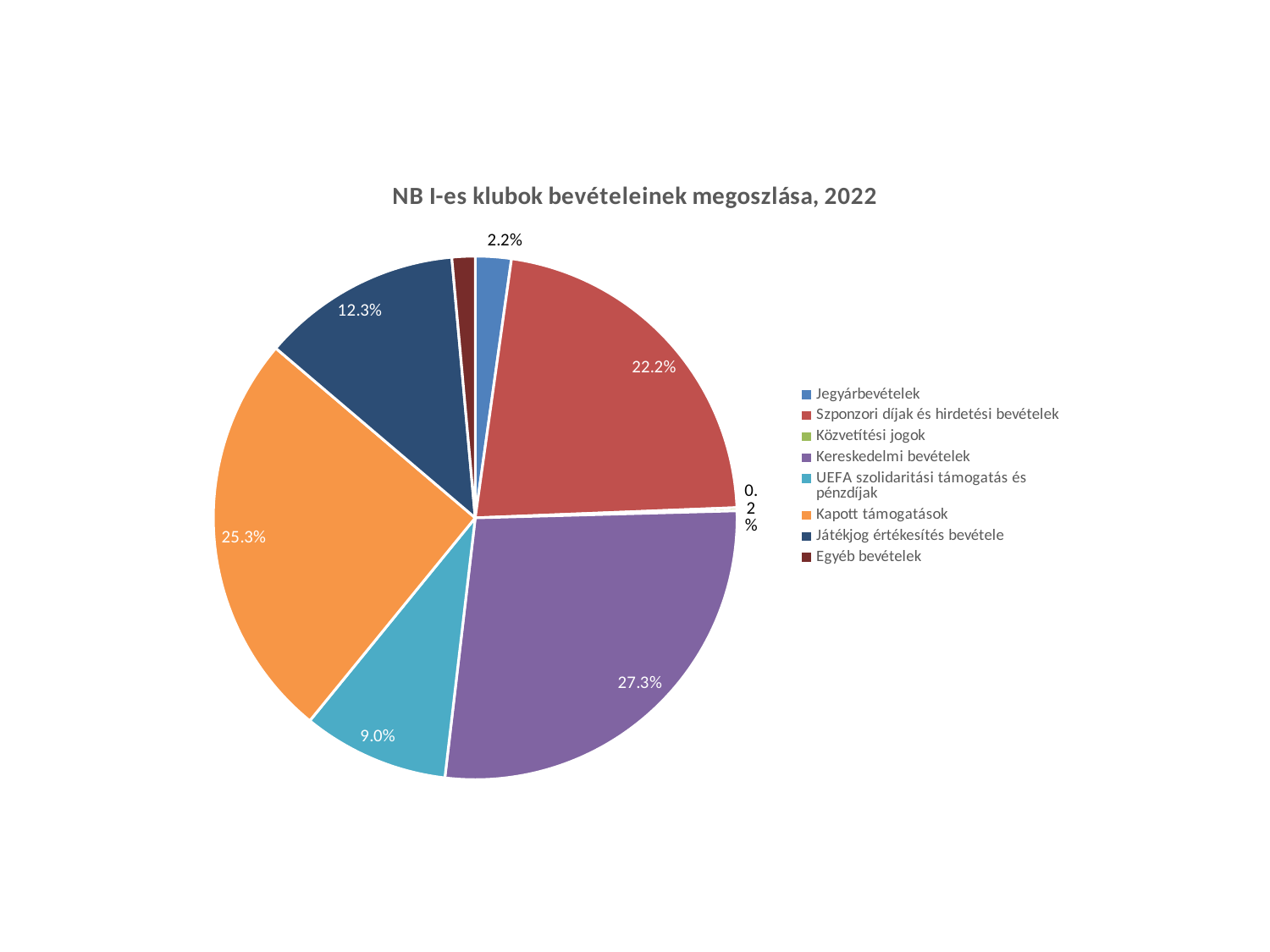
What share of the pie is Jegyárbevételek? 2.2% What share of the pie is UEFA szolidaritási támogatás és pénzdíjak? 9.0% What share of the pie is Kereskedelmi bevételek? 27.3% What share of the pie is Játékjog értékesítés bevétele? 12.3% What is the title of the chart? NB I-es klubok bevételeinek megoszlása, 2022 What share of the pie is Szponzori díjak és hirdetési bevételek? 22.2% How many categories does the legend list? 8 What is the difference in percentage points between Kereskedelmi bevételek and Kapott támogatások? 2.0 percentage points What share of the pie is Kapott támogatások? 25.3% Which is larger: Szponzori díjak és hirdetési bevételek or Kapott támogatások? Kapott támogatások Which category has the largest share of the pie? Kereskedelmi bevételek What type of chart is shown on the slide? Pie chart